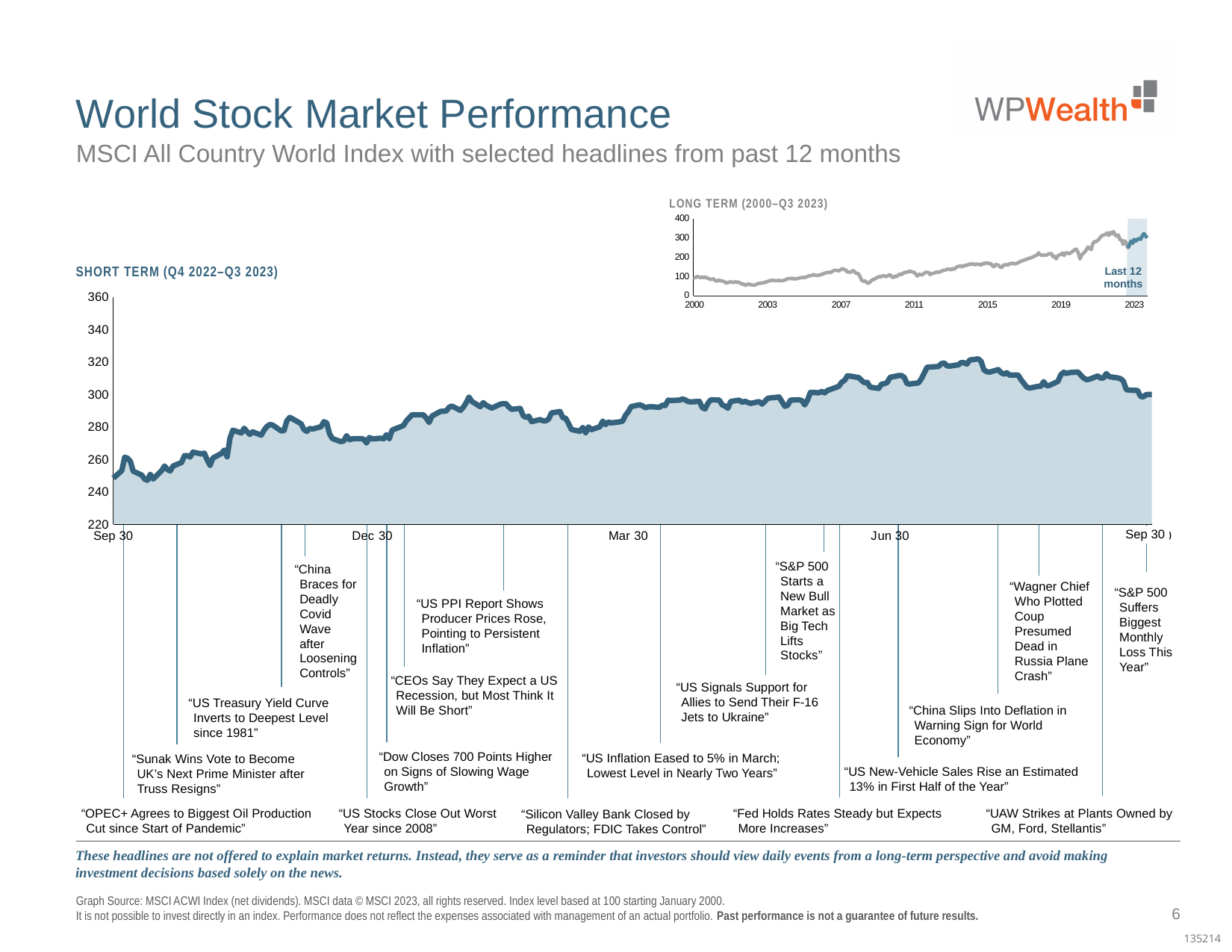
What is the title of the smaller chart in the upper right of the slide? LONG TERM (2000–Q3 2023) On the SHORT TERM chart, is the index value at Mar 30 greater or less than 300? less On the LONG TERM chart, does the index overall rise or fall from 2000 to 2023? rise On the SHORT TERM chart, is the index value at the final Sep 30 (2023) greater or less than 280? greater On the LONG TERM (2000–Q3 2023) chart, what index level does the line start at in 2000? 100 On the SHORT TERM chart, does the index overall rise or fall from Sep 30, 2022 to Sep 30, 2023? rise On the SHORT TERM chart, is the highest point reached by the line greater or less than 300? greater What kind of chart is the SHORT TERM (Q4 2022–Q3 2023) chart? line chart How many date labels are shown on the x axis of the SHORT TERM chart? 5